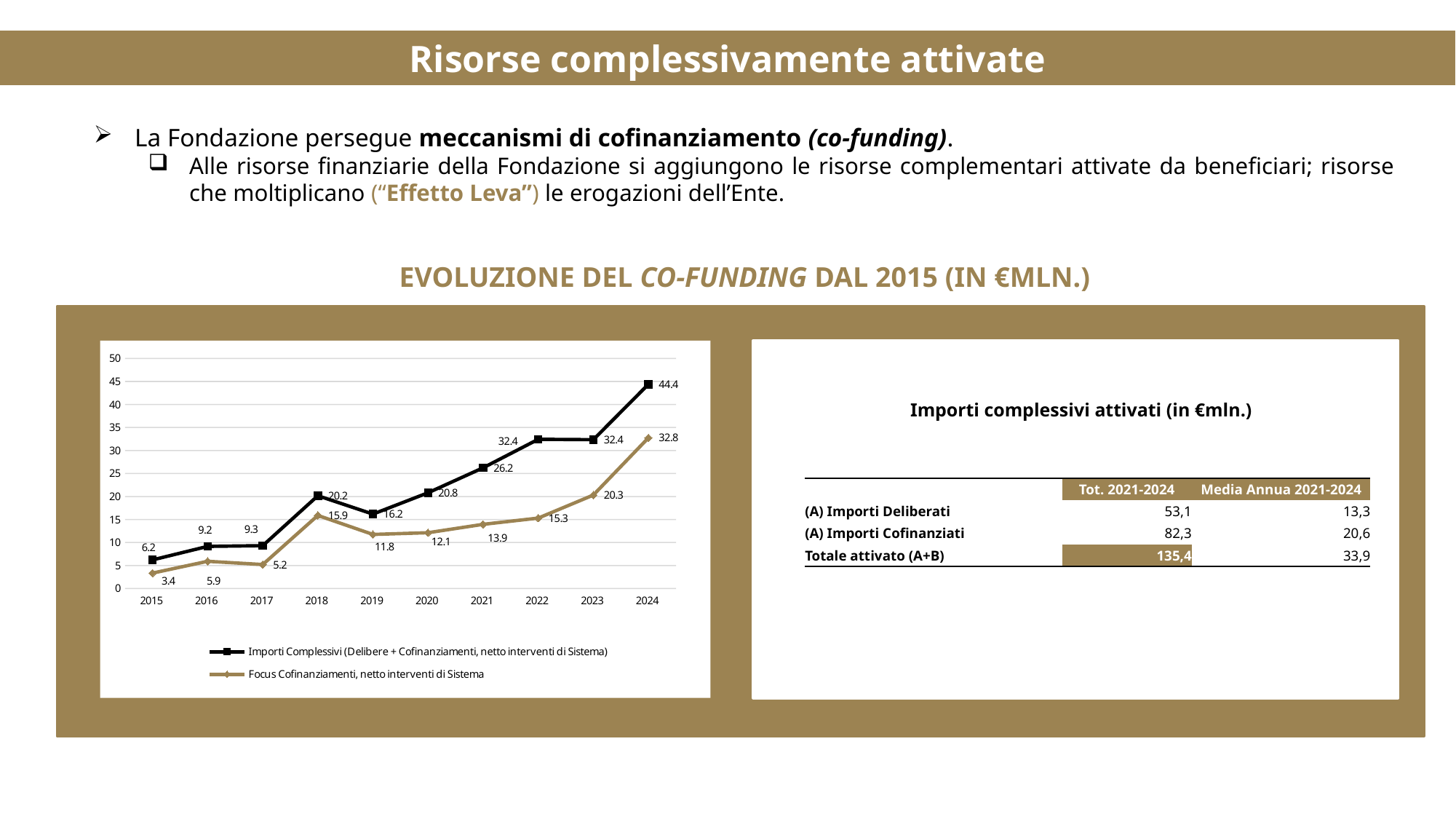
What is the value of Focus Cofinanziamenti in 2019? 11.8 How many years are plotted on the x axis of the chart? 10 Is the value of Focus Cofinanziamenti in 2023 greater or less than 25? less In which year is Importi Complessivi at its highest? 2024 Which is larger: Importi Complessivi in 2021 or Importi Complessivi in 2020? 2021 What type of chart is shown on the slide? line chart What is the title shown above the chart? EVOLUZIONE DEL CO-FUNDING DAL 2015 (IN €MLN.) How many series does the chart legend list? 2 What is the value of Importi Complessivi in 2024? 44.4 In which year is Focus Cofinanziamenti at its lowest? 2015 What is the difference between Importi Complessivi and Focus Cofinanziamenti in 2024? 11.6 What is the value of Importi Complessivi in 2018? 20.2